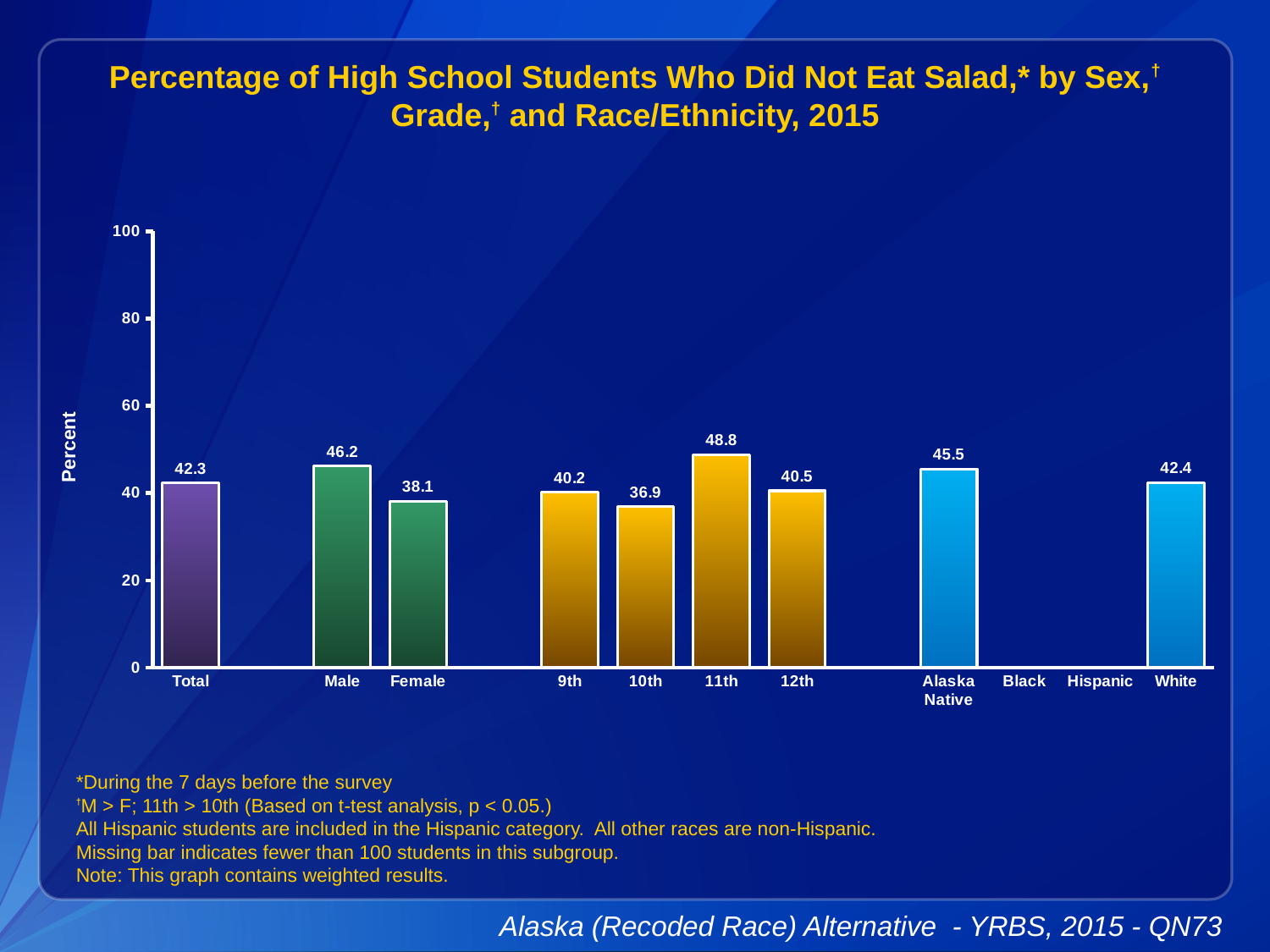
What is the value for Female? 38.1 What is the value for 11th grade? 48.8 How many categories have a bar shown? 9 What kind of chart is this? bar chart Which is larger, the value for 9th grade or 12th grade? 12th Which category has the highest value? 11th What is the label on the y axis? Percent Is the value for White greater or less than 40? greater What is the difference between the Male and Female values? 8.1 What is the value for Total? 42.3 Which category with a bar has the lowest value? 10th What is the value for Alaska Native? 45.5